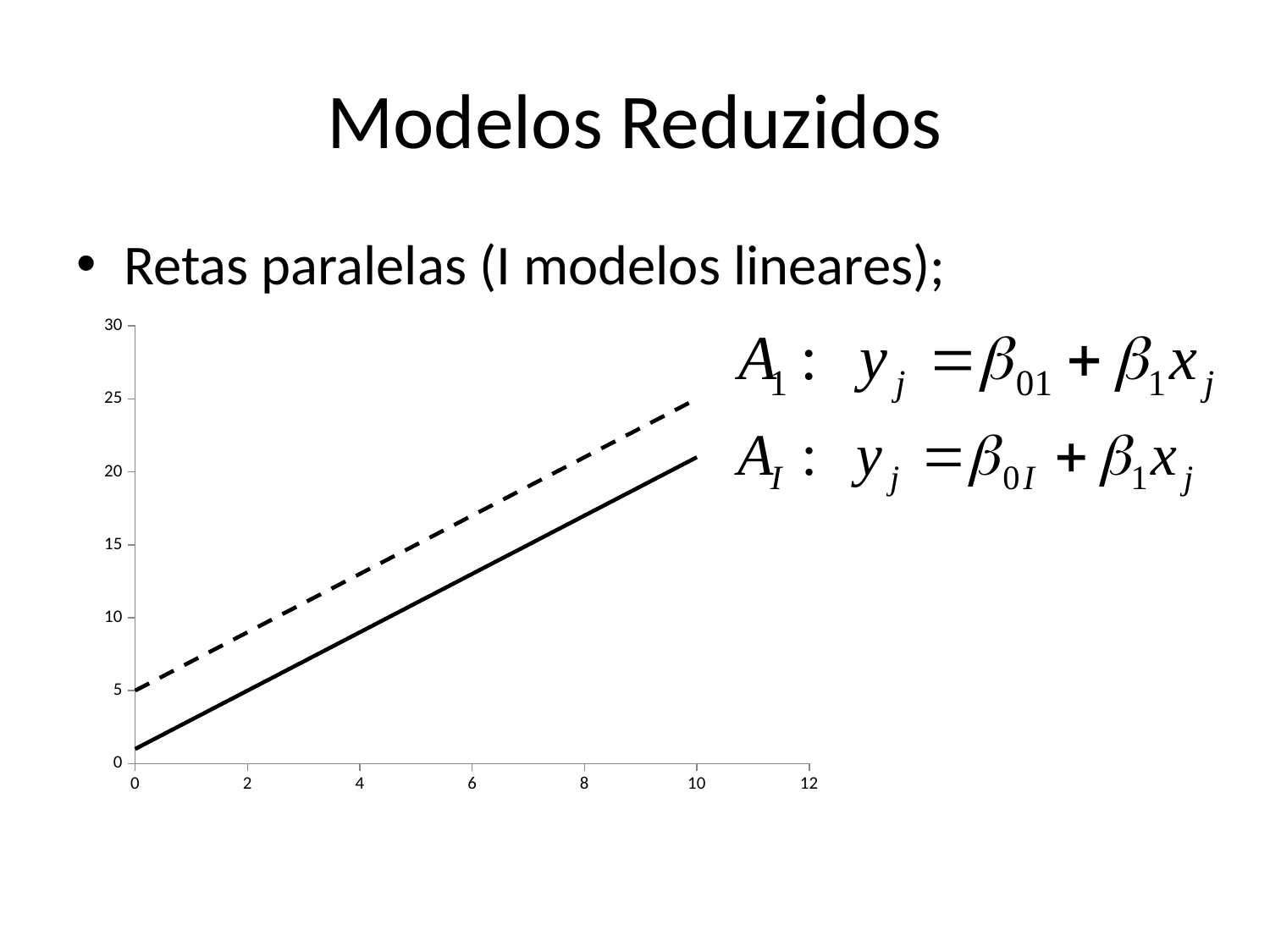
Is the value of the dashed line at x = 10 greater or less than 20? greater Is the value of the solid line at x = 6 greater or less than 10? greater What kind of chart is shown on the slide? line chart Is the value of the solid line at x = 10 greater or less than 15? greater At x = 10, which line is higher, the dashed line or the solid line? dashed line Do the lines rise or fall as x increases from 0 to 10? rise What is the highest tick value shown on the x axis? 12 How many lines are plotted on the chart? 2 At x = 4, which line is higher, the solid line or the dashed line? dashed line What is the highest tick value shown on the y axis? 30